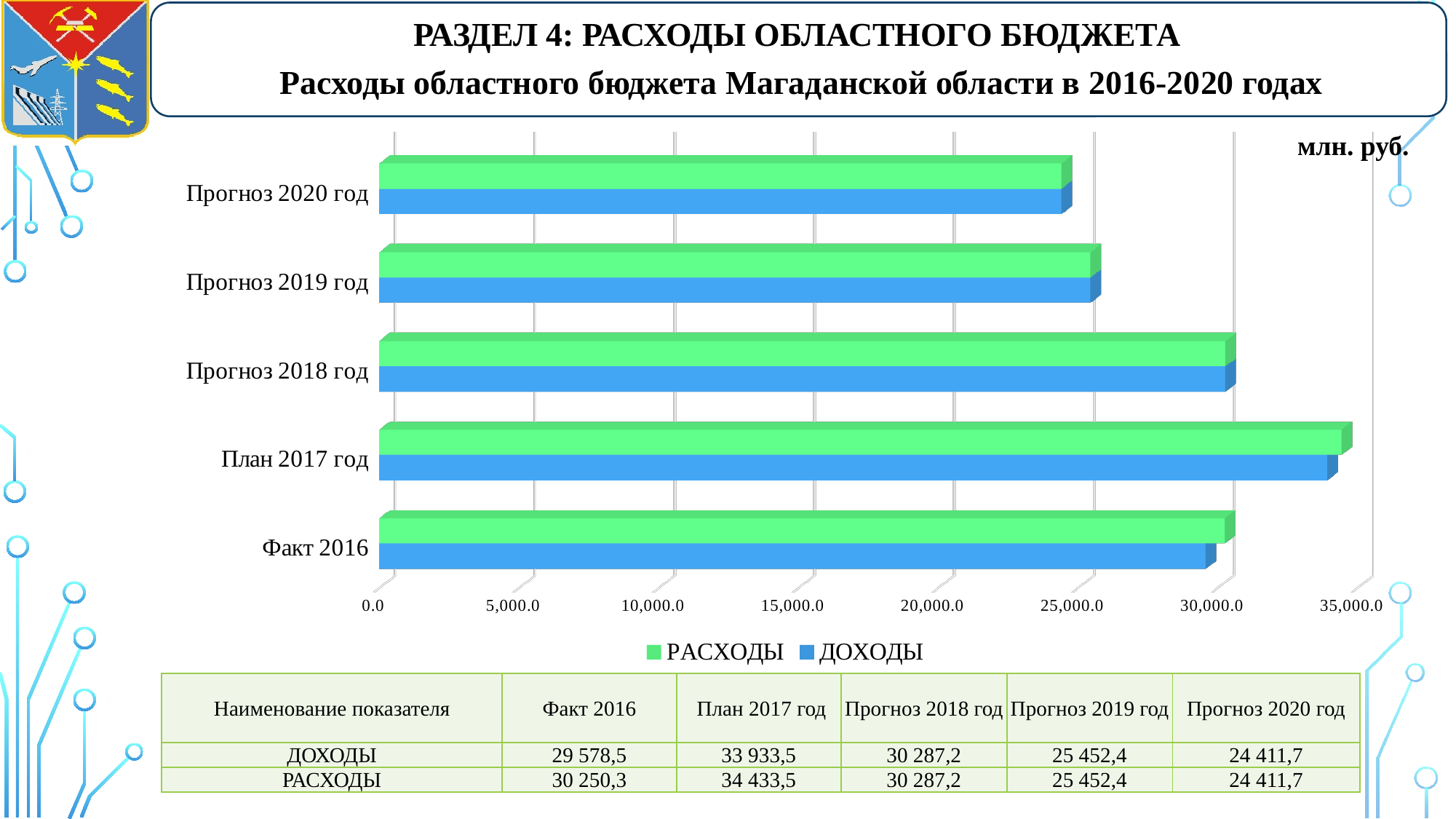
Which category has the lowest value of ДОХОДЫ? Прогноз 2020 год Which is larger for План 2017 год: РАСХОДЫ or ДОХОДЫ? РАСХОДЫ What unit of measurement is indicated for the chart values? млн. руб. How many series does the chart legend list? 2 What kind of chart is shown on the slide? bar chart Which category has the highest value of РАСХОДЫ? План 2017 год What is the difference between РАСХОДЫ and ДОХОДЫ for Факт 2016? 671,8 Is the value of ДОХОДЫ for План 2017 год greater or less than 30,000.0? greater What is the value of ДОХОДЫ for Факт 2016? 29 578,5 What is the value of ДОХОДЫ for Прогноз 2020 год? 24 411,7 What is the value of РАСХОДЫ for План 2017 год? 34 433,5 How many categories (years) are plotted on the chart? 5